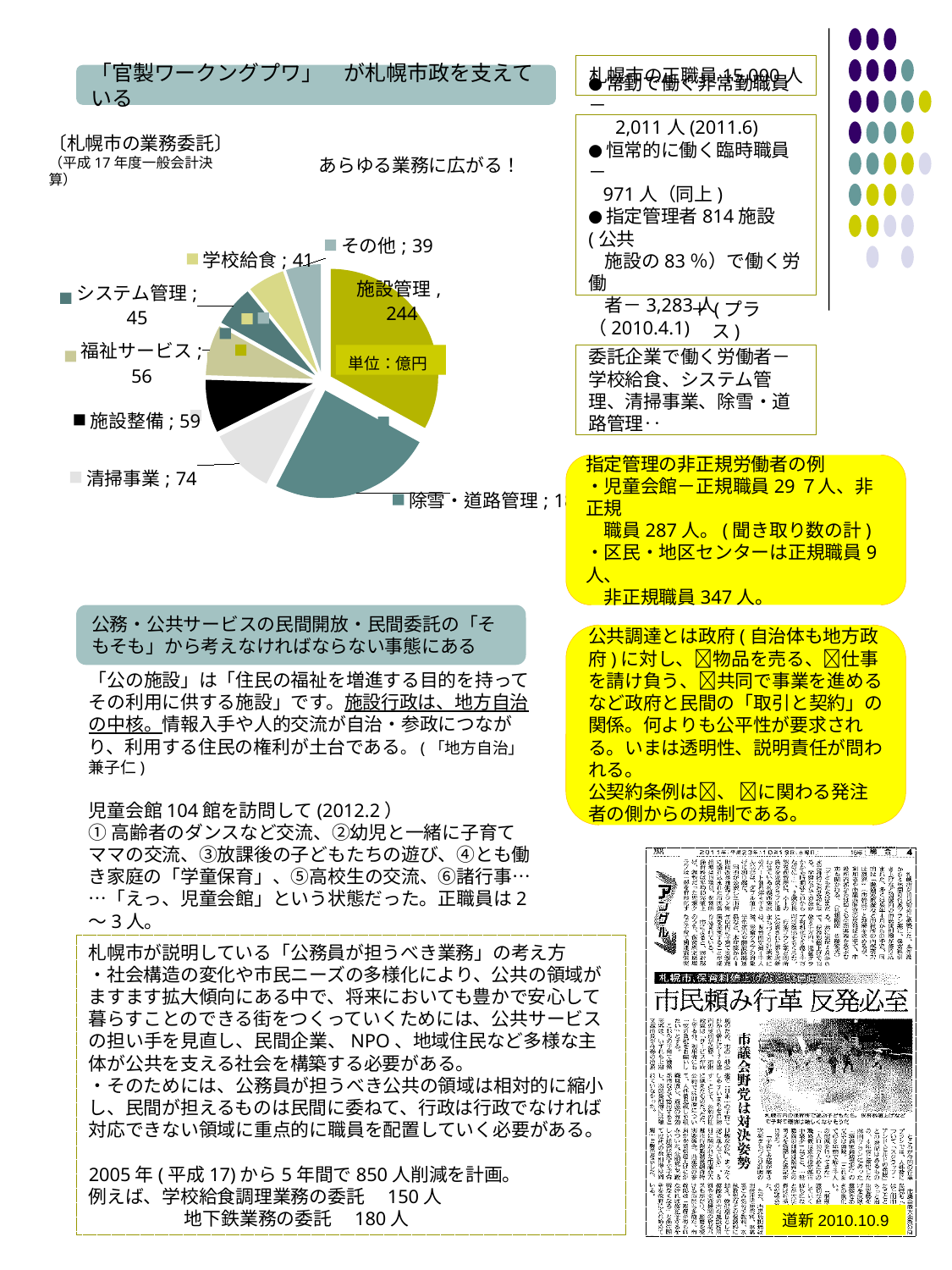
What is the value for システム管理 in the pie chart? 45 What is the value for その他 in the pie chart? 39 What is the value for 施設整備 in the pie chart? 59 What is the value for 清掃事業 in the pie chart? 74 What is the difference between the values for 施設管理 and 清掃事業? 170 Which is larger, the value for 福祉サービス or the value for システム管理? 福祉サービス Which category has the largest value in the pie chart? 施設管理 What unit is shown for the values in the pie chart? 億円 What is the value for 施設管理 in the pie chart? 244 What is the value for 学校給食 in the pie chart? 41 What kind of chart is shown on the slide? pie chart What is the value for 福祉サービス in the pie chart? 56